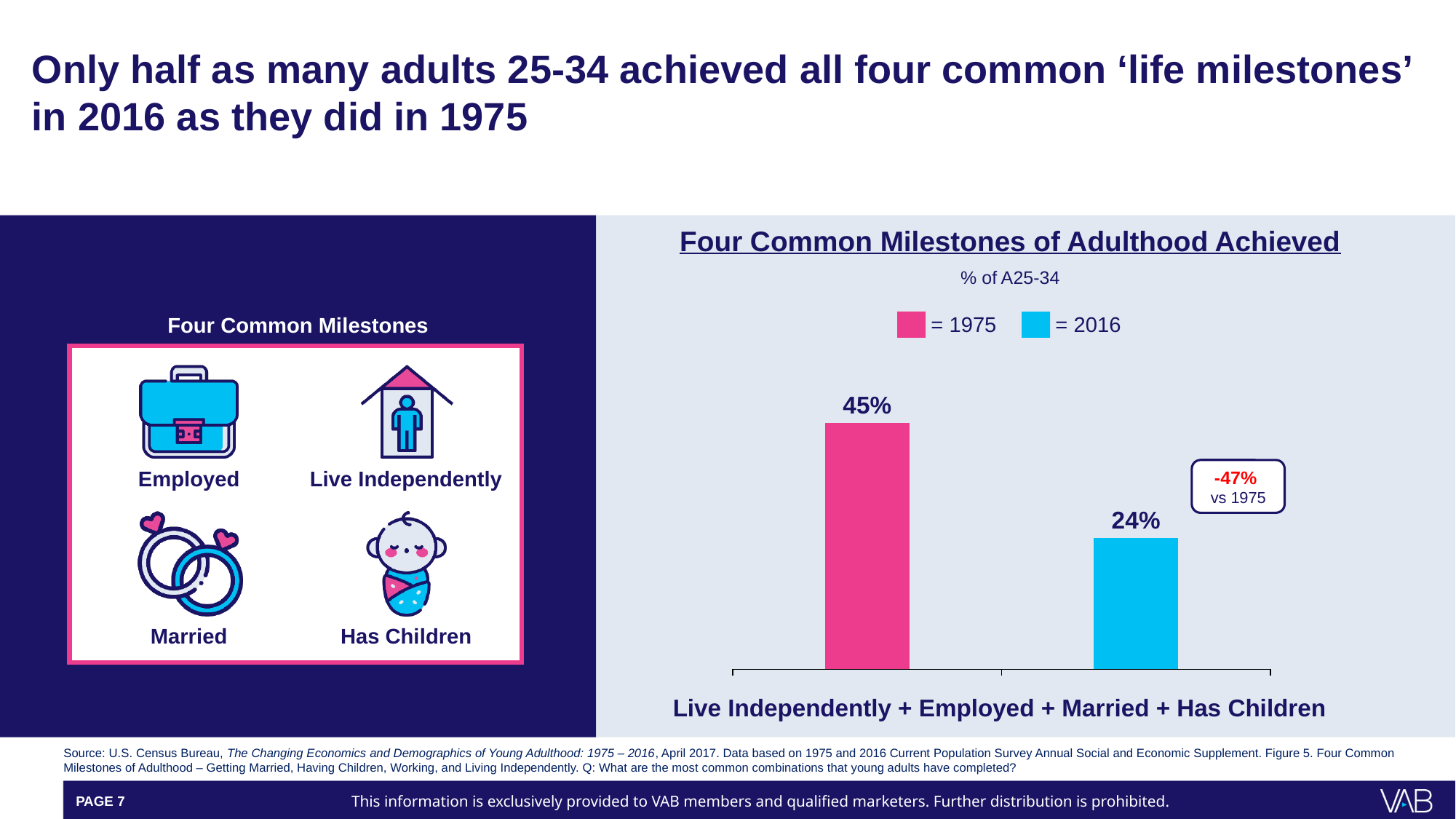
How many bars are plotted in the chart? 2 How many series does the legend list? 2 What percentage of adults 25-34 achieved all four milestones in 1975? 45% Which year shows the lowest percentage of adults 25-34 achieving all four milestones? 2016 What percentage change vs 1975 is shown in the callout next to the 2016 bar? -47% What kind of chart is shown on the slide? Bar chart What percentage of adults 25-34 achieved all four milestones in 2016? 24% Which colour represents 2016 in the chart? Blue Which year has the higher value, 1975 or 2016? 1975 What is the title of the chart? Four Common Milestones of Adulthood Achieved What is the difference in percentage points between the 1975 and 2016 values? 21 percentage points Does the value fall or rise from 1975 to 2016? Fall